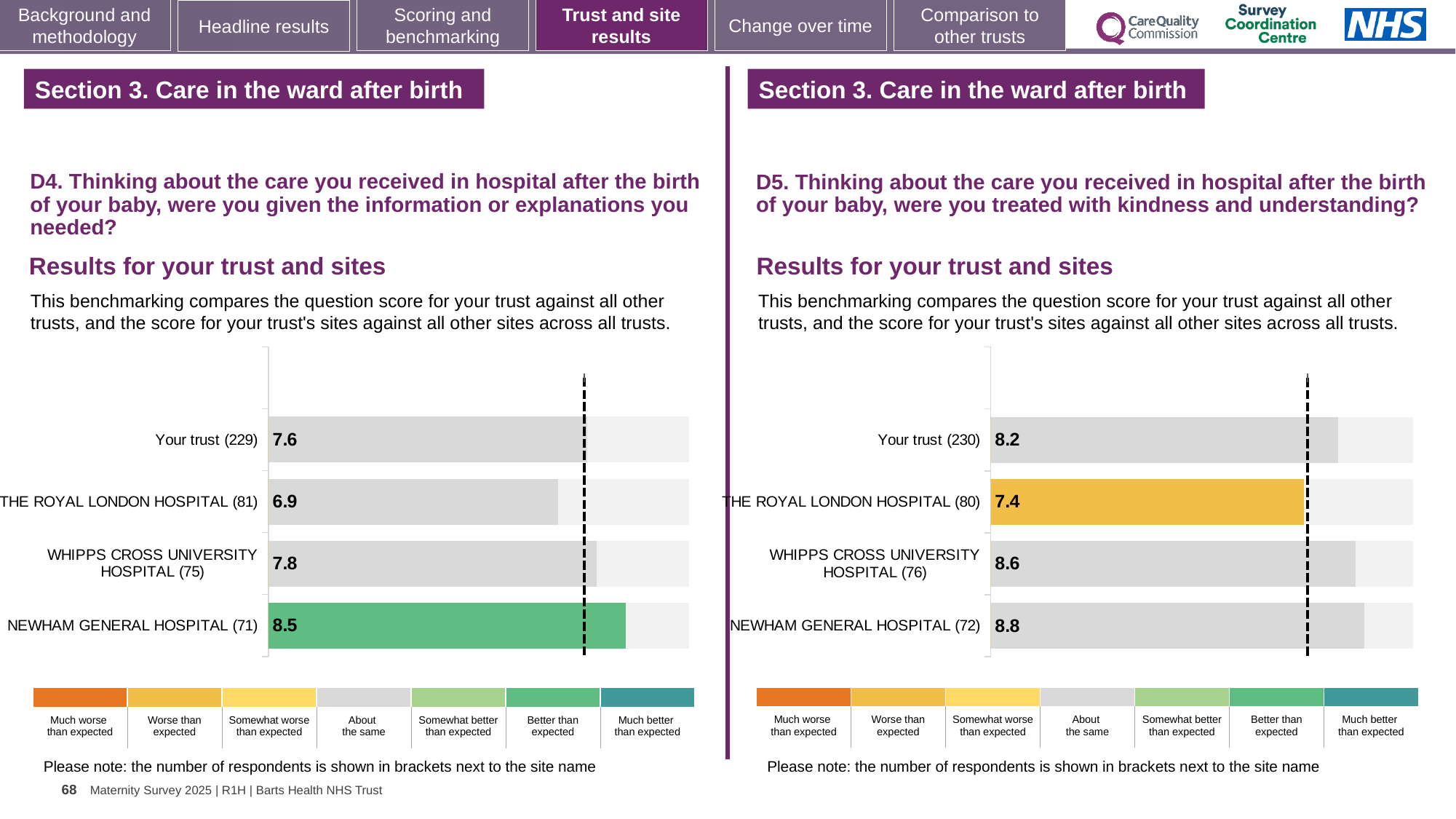
In the D5 chart on the right, what is the difference between the scores for Your trust and THE ROYAL LONDON HOSPITAL? 0.8 In the D4 chart on the left, what is the score for Your trust? 7.6 In the D4 chart on the left, which site has the highest score? NEWHAM GENERAL HOSPITAL In the D5 chart on the right, what is the score for NEWHAM GENERAL HOSPITAL? 8.8 In the D5 chart on the right, which site has the lowest score? THE ROYAL LONDON HOSPITAL In the D4 chart on the left, how many bars are plotted? 4 In the D5 chart on the right, which is larger: the score for Your trust or the score for THE ROYAL LONDON HOSPITAL? Your trust In the D4 chart on the left, which site has the lowest score? THE ROYAL LONDON HOSPITAL In the D4 chart on the left, what is the score for THE ROYAL LONDON HOSPITAL? 6.9 What type of chart is used in the D4 chart on the left? Bar chart In the D5 chart on the right, what is the score for WHIPPS CROSS UNIVERSITY HOSPITAL? 8.6 In the D4 chart on the left, what is the difference between the scores for NEWHAM GENERAL HOSPITAL and THE ROYAL LONDON HOSPITAL? 1.6